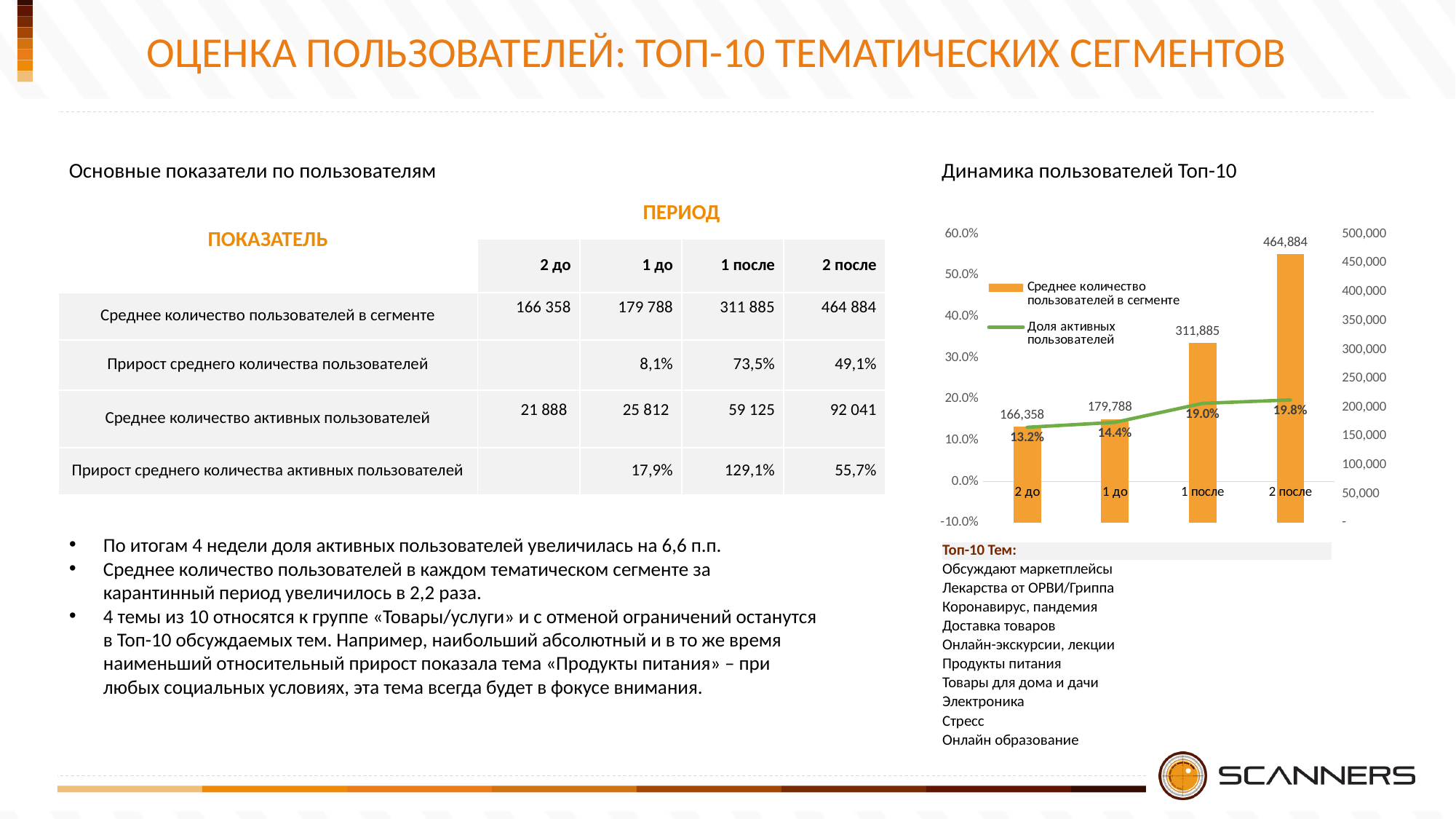
In the chart 'Динамика пользователей Топ-10', what is the average number of users in the segment for '1 после'? 311,885 How many periods are shown on the x axis of the chart 'Динамика пользователей Топ-10'? 4 In the chart 'Динамика пользователей Топ-10', what is the average number of users in the segment for the period '2 после'? 464,884 In the chart 'Динамика пользователей Топ-10', which period has the highest average number of users in the segment? 2 после In the chart 'Динамика пользователей Топ-10', does the share of active users rise or fall from '2 до' to '2 после'? Rises In the chart 'Динамика пользователей Топ-10', which period has the lowest share of active users? 2 до In the chart 'Динамика пользователей Топ-10', what is the difference in average number of users between '2 после' and '1 после'? 152,999 In the chart 'Динамика пользователей Топ-10', what is the share of active users for the period '2 до'? 13.2% In the chart 'Динамика пользователей Топ-10', which period has a larger average number of users: '1 до' or '1 после'? 1 после In the chart 'Динамика пользователей Топ-10', by how many percentage points does the share of active users in '2 после' exceed that in '2 до'? 6.6 What kind of chart is 'Динамика пользователей Топ-10'? Combined bar and line chart How many series does the legend of the chart 'Динамика пользователей Топ-10' list? 2